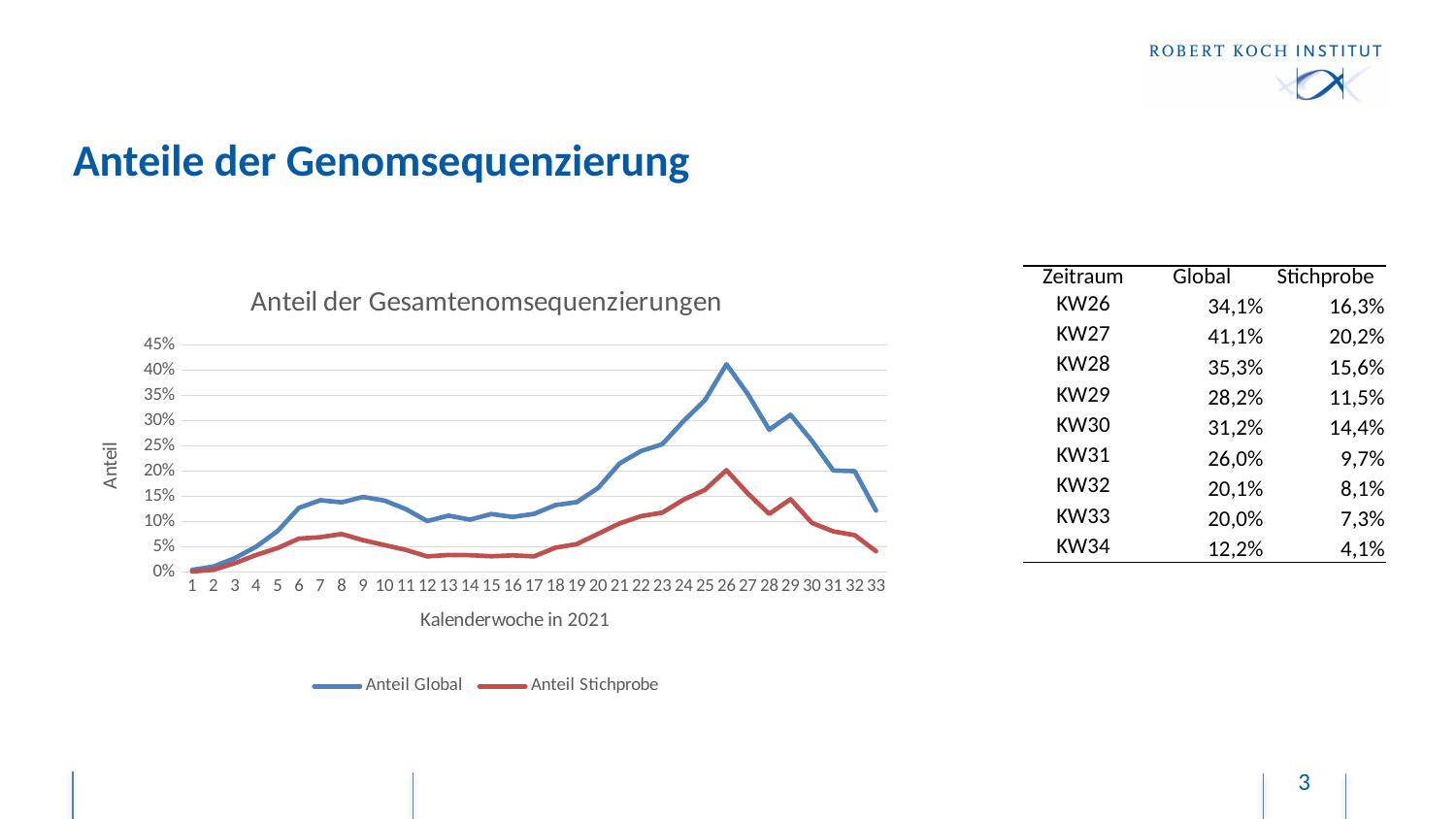
What is the title of the chart? Anteil der Gesamtenomsequenzierungen What kind of chart is shown on the slide? line chart At which calendar week does the Anteil Global series reach its highest value? 26 At which calendar week does the Anteil Stichprobe series reach its highest value? 26 How many calendar weeks are plotted along the x axis of the chart? 33 Does the Anteil Global series rise or fall between calendar week 26 and calendar week 33? fall How many series does the chart legend list? 2 Is the value of Anteil Global at calendar week 26 greater or less than 35%? greater Is the value of Anteil Stichprobe at calendar week 33 greater or less than 5%? less At calendar week 20, which series has the larger value, Anteil Global or Anteil Stichprobe? Anteil Global Is the value of Anteil Global at calendar week 12 greater or less than 15%? less At which calendar week is the Anteil Global series at its lowest value? 1